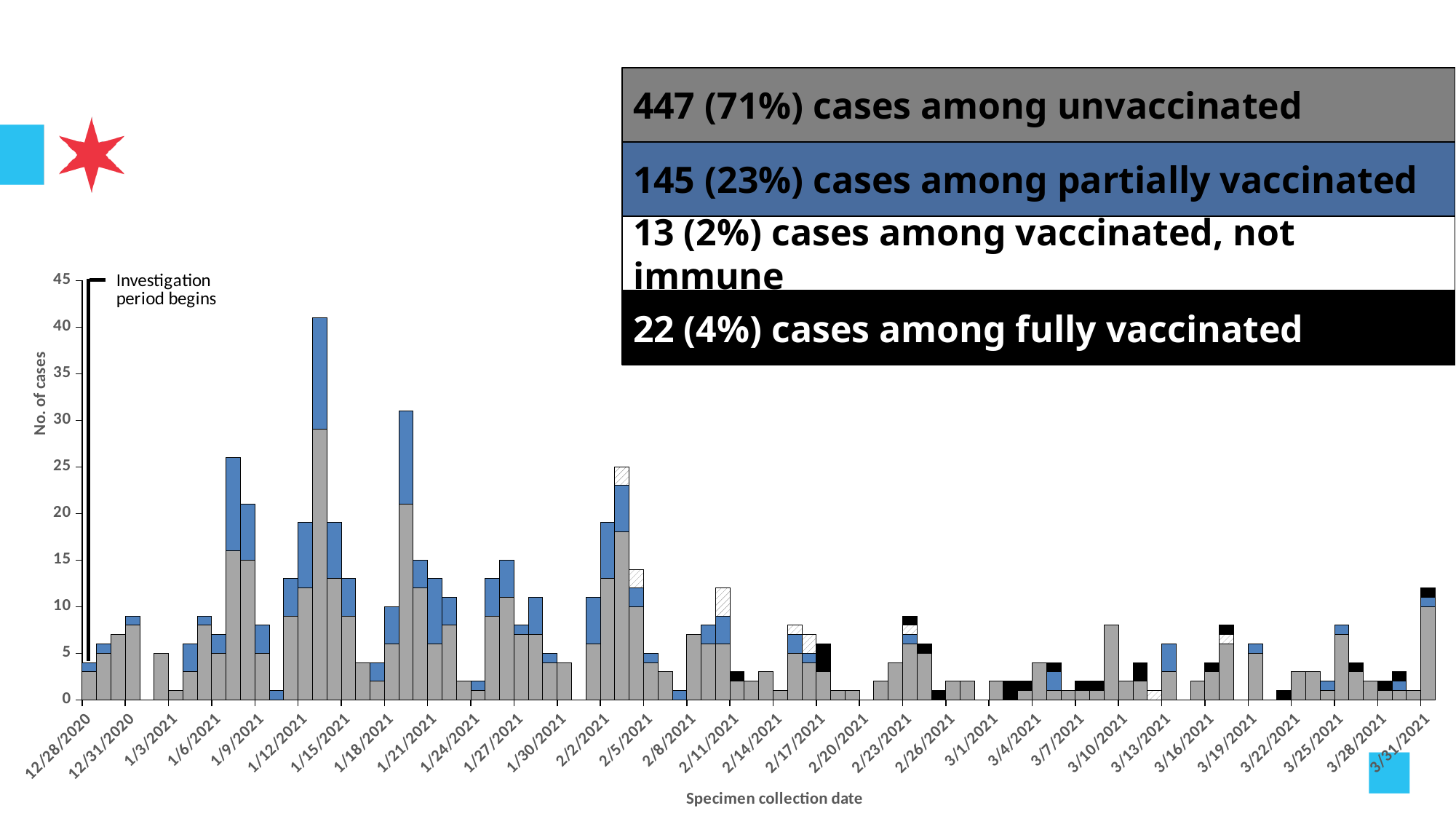
Which bar is taller: the one for 12/28/2020 or the one for 3/31/2021? 3/31/2021 How many cases were among unvaccinated people? 447 (71%) Is the tallest bar in the chart greater or less than 35 cases? greater How many cases were among fully vaccinated people? 22 (4%) What percentage of cases were among unvaccinated people? 71% What is the label of the x axis? Specimen collection date How many more cases were among unvaccinated people than among partially vaccinated people? 302 Which vaccination-status category has the fewest cases? Vaccinated, not immune Which vaccination-status category has the most cases? Unvaccinated What kind of chart is shown on the slide? Stacked bar chart How many cases were among partially vaccinated people? 145 (23%) How many vaccination-status categories does the legend box list? 4